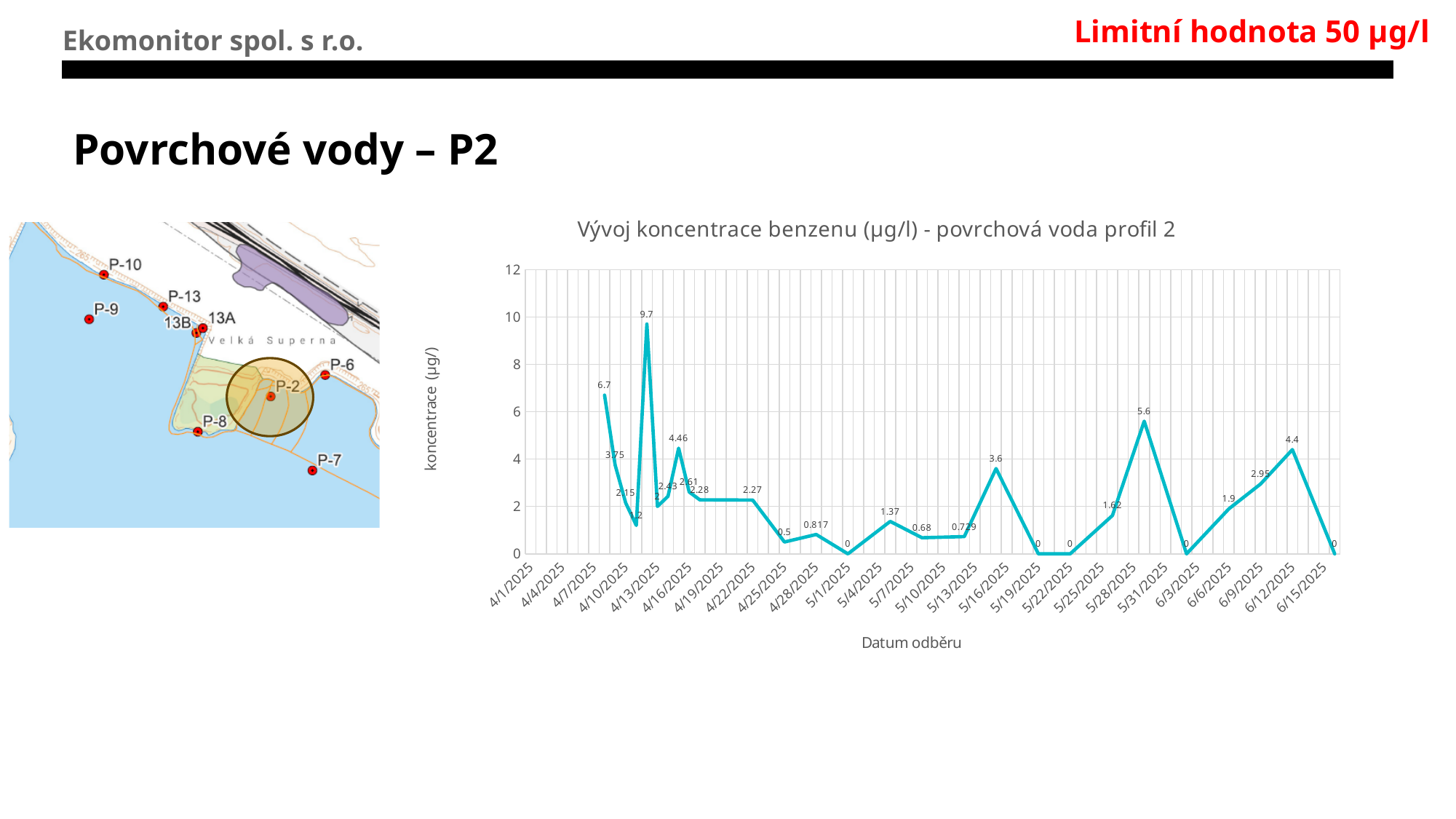
What is the difference between the highest value (9.7) and the first value (6.7)? 3 What is the value of the peak in mid-June (around 6/12/2025)? 4.4 What is the title of the chart? Vývoj koncentrace benzenu (µg/l) - povrchová voda profil 2 What is the value of the first data point on the chart (early April)? 6.7 What type of chart is shown on the slide? line chart What is the label of the y axis? koncentrace (µg/l) What is the value of the peak in late May (around 5/28/2025)? 5.6 What is the highest benzene concentration value plotted on the chart? 9.7 What is the value of the last data point on the chart (6/15/2025)? 0 What is the lowest value plotted on the chart? 0 Which is larger: the late-May peak (5.6) or the mid-June peak (4.4)? 5.6 Is the highest plotted value greater or less than 8? greater